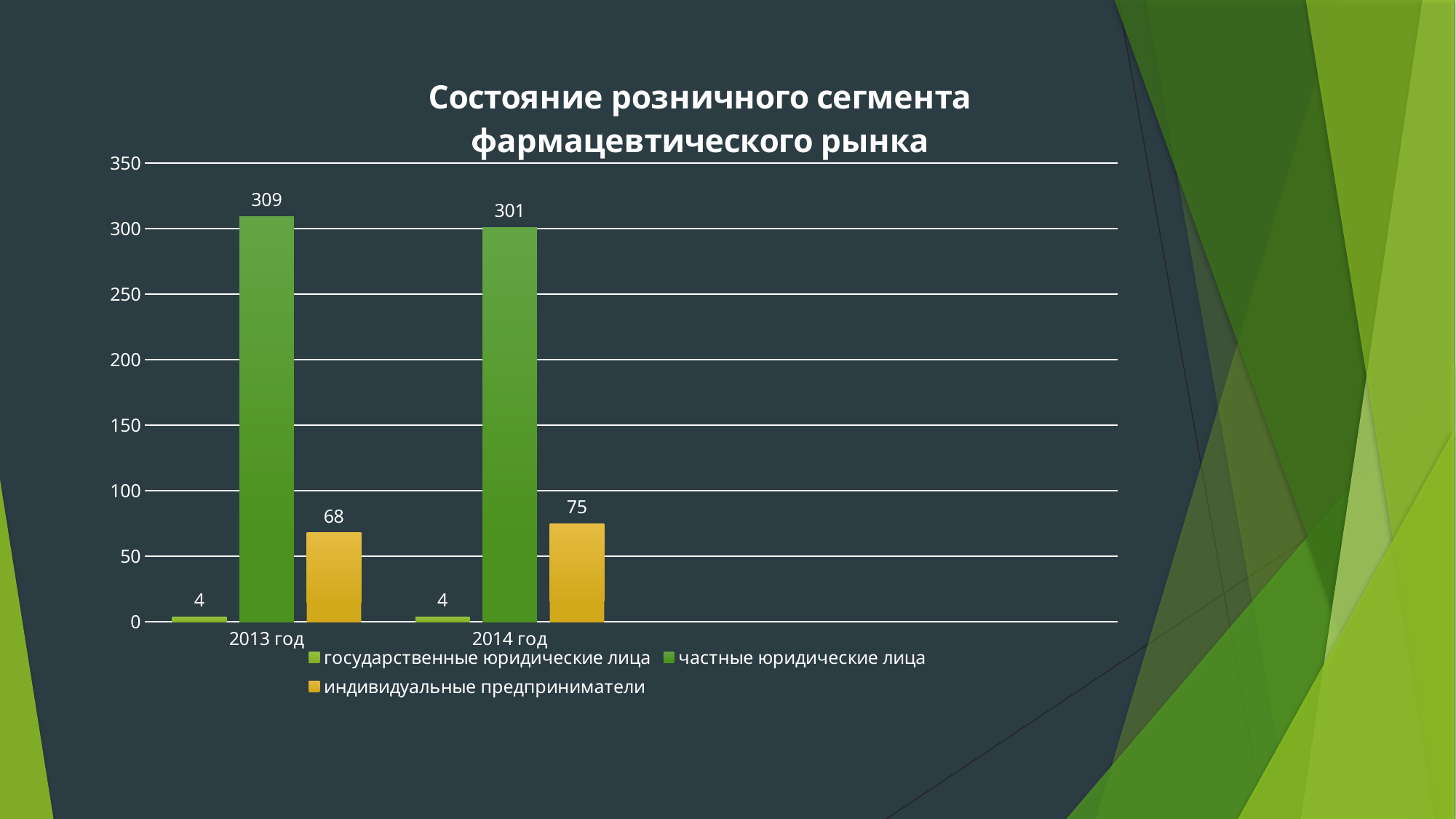
Which series has the highest value in 2014 год? частные юридические лица What is the value for государственные юридические лица in 2013 год? 4 Which is larger: индивидуальные предприниматели in 2013 год or in 2014 год? 2014 год What is the value for индивидуальные предприниматели in 2014 год? 75 What is the value for индивидуальные предприниматели in 2013 год? 68 How many year categories are shown on the x axis? 2 What is the title of the chart? Состояние розничного сегмента фармацевтического рынка What is the difference between the values for частные юридические лица in 2013 год and 2014 год? 8 Which series has the lowest value in 2013 год? государственные юридические лица What is the value for частные юридические лица in 2013 год? 309 How many series does the legend list? 3 What kind of chart is shown on the slide? bar chart